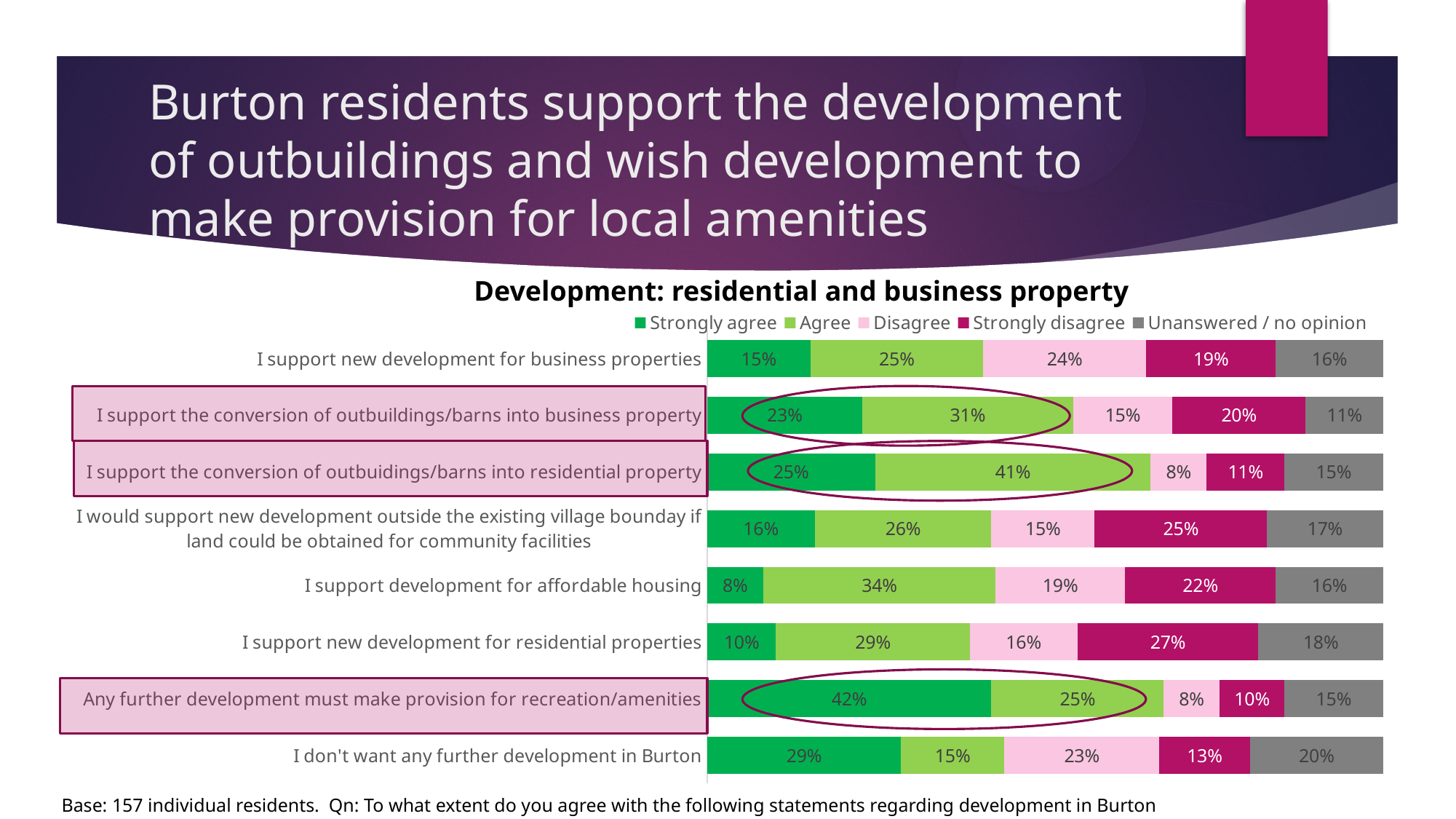
What type of chart is shown on the slide? Stacked bar chart Which statement has the lowest Strongly agree percentage? I support development for affordable housing How many statements are shown in the chart? 8 What is the Unanswered / no opinion value for 'I don't want any further development in Burton'? 20% How many series does the legend list? 5 What is the Strongly disagree value for 'I support new development for residential properties'? 27% Which statement has the highest Strongly agree percentage? Any further development must make provision for recreation/amenities Which is larger: the Strongly disagree value for 'I support new development for residential properties' or for 'I support development for affordable housing'? I support new development for residential properties What percentage of residents strongly agree that any further development must make provision for recreation/amenities? 42% What is the Agree value for 'I support the conversion of outbuidings/barns into residential property'? 41% What is the difference between the Agree values for conversion of outbuildings/barns into residential property and into business property? 10% What is the title of the chart? Development: residential and business property